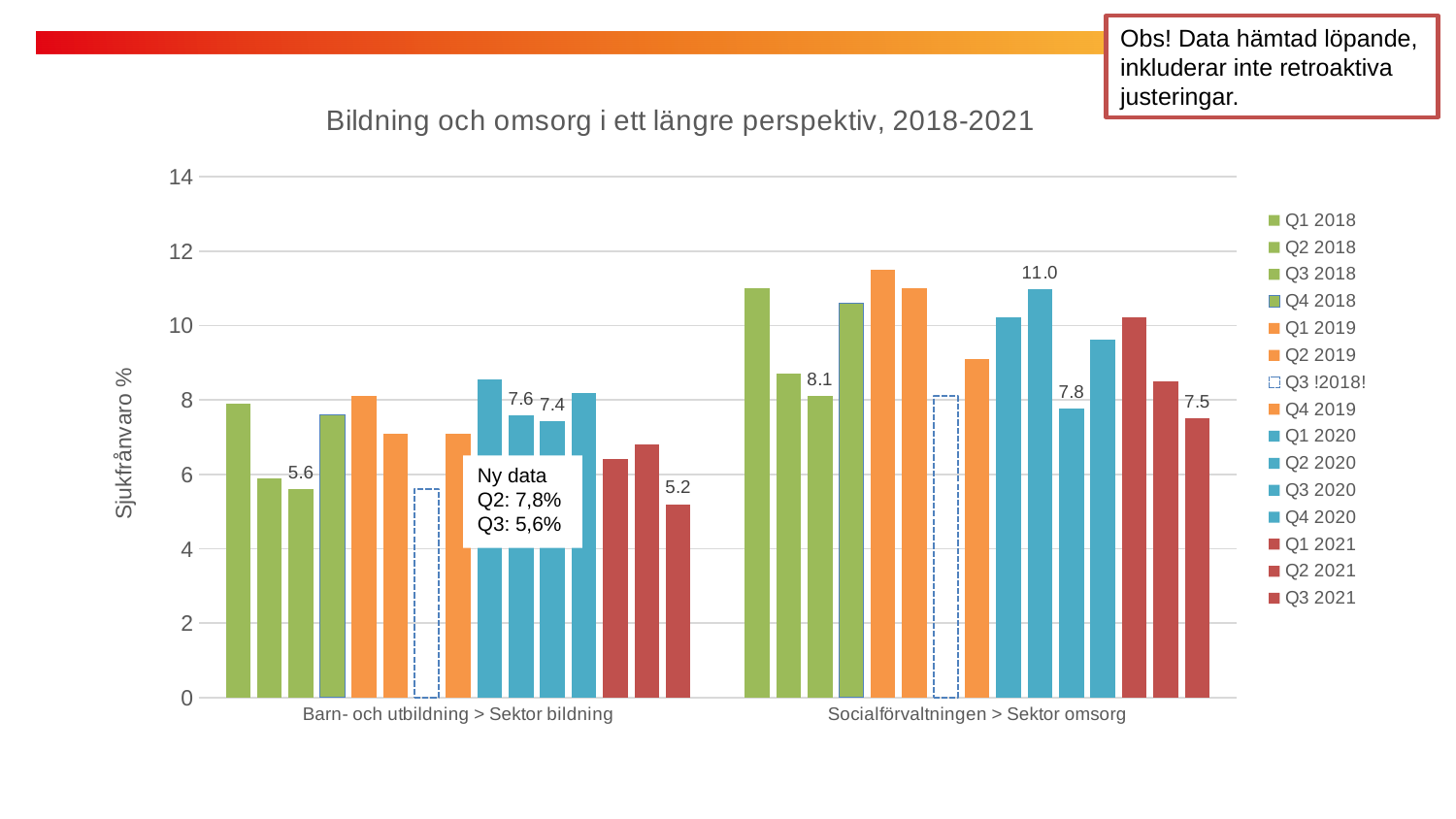
What is the Q3 2018 value for Barn- och utbildning > Sektor bildning? 5.6 How many categories are shown on the x axis? 2 How many series does the legend list? 15 What is the Q2 2020 value for Socialförvaltningen > Sektor omsorg? 11.0 Is the Q1 2019 value for Socialförvaltningen > Sektor omsorg greater or less than 10? greater What kind of chart is shown on the slide? bar chart What is the Q3 2021 value for Barn- och utbildning > Sektor bildning? 5.2 Which category has the larger Q3 2020 value, Barn- och utbildning > Sektor bildning or Socialförvaltningen > Sektor omsorg? Socialförvaltningen > Sektor omsorg Is the Q1 2021 value for Barn- och utbildning > Sektor bildning greater or less than 8? less What is the title of the y axis? Sjukfrånvaro % What is the difference between the Q3 2021 values for Socialförvaltningen > Sektor omsorg and Barn- och utbildning > Sektor bildning? 2.3 What is the Q3 2021 value for Socialförvaltningen > Sektor omsorg? 7.5